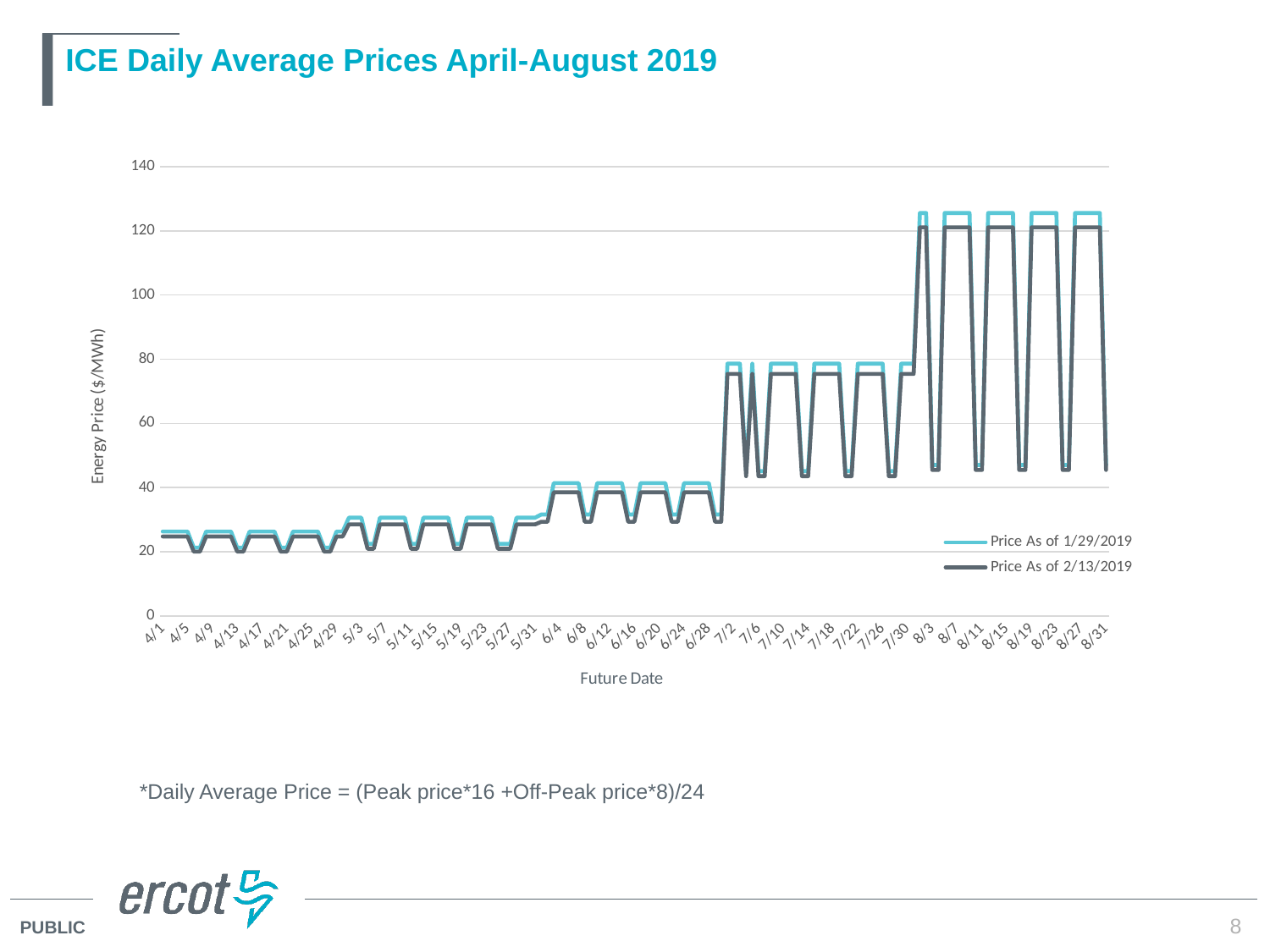
Do the prices generally rise or fall from April to August along the x axis? rise What kind of chart is shown on the slide? Line chart Is the value of the 'Price As of 1/29/2019' series on 5/3 greater or less than 60? less What is the label of the vertical axis? Energy Price ($/MWh) How many series does the legend list? 2 Is the value of the 'Price As of 2/13/2019' series on 6/4 greater or less than 60? less What is the title of the chart? ICE Daily Average Prices April-August 2019 Is the value of the 'Price As of 1/29/2019' series on 8/3 greater or less than 100? less In August, which series shows the higher peak prices: 'Price As of 1/29/2019' or 'Price As of 2/13/2019'? Price As of 1/29/2019 In which month do the plotted prices reach their highest level? August